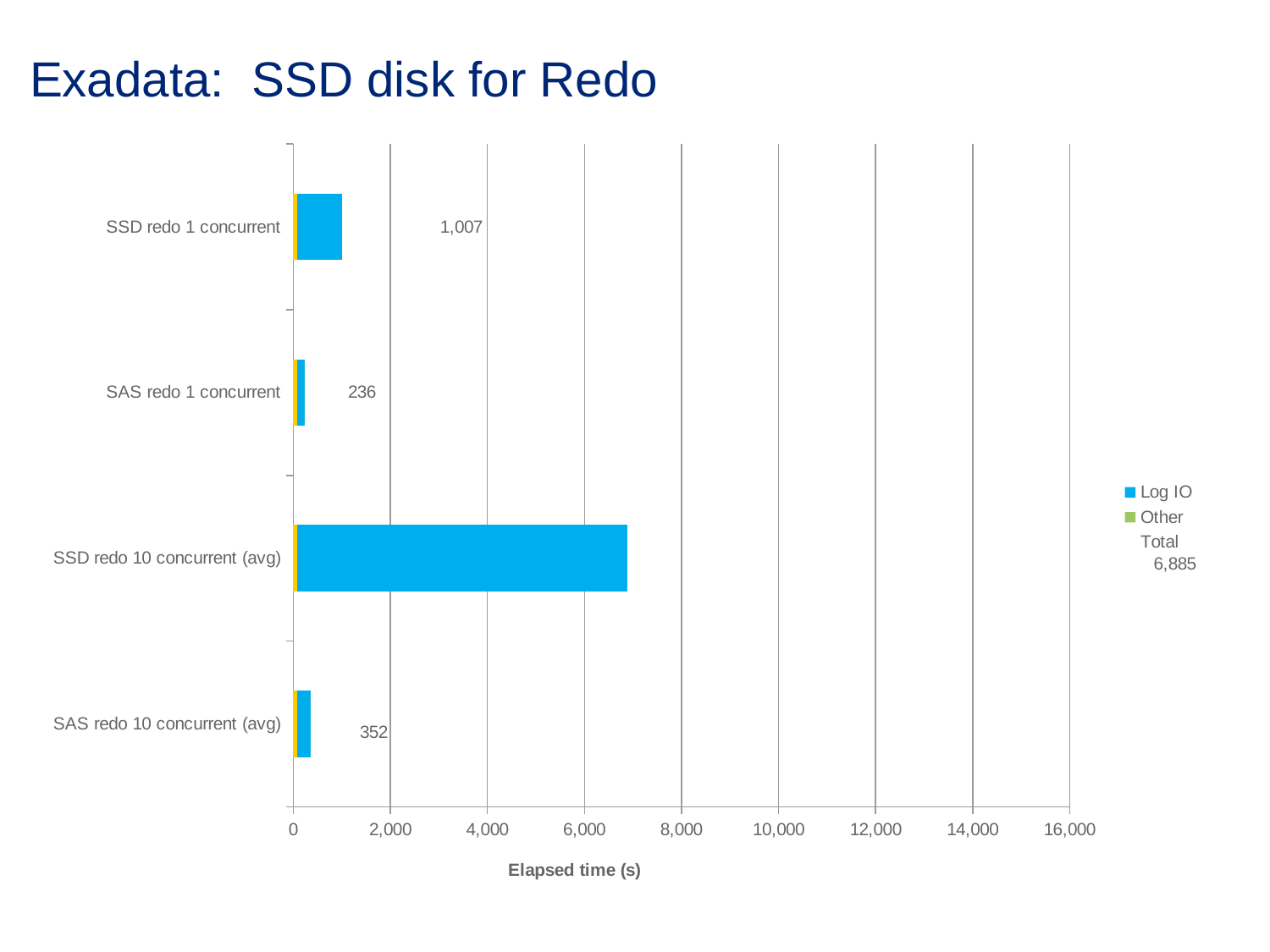
What kind of chart is shown on the slide? bar chart Which category has the longest elapsed time? SSD redo 10 concurrent (avg) Which category has the shortest elapsed time? SAS redo 1 concurrent Is the value for SSD redo 10 concurrent (avg) greater or less than 6,000? greater What is the value shown for SSD redo 1 concurrent? 1,007 What is the value shown for SAS redo 1 concurrent? 236 What is the difference between the values for SSD redo 1 concurrent and SAS redo 1 concurrent? 771 How many categories are shown on the chart? 4 What is the difference between the values for SAS redo 10 concurrent (avg) and SAS redo 1 concurrent? 116 Which is larger: the value for SSD redo 1 concurrent or the value for SAS redo 10 concurrent (avg)? SSD redo 1 concurrent What is the value shown for SAS redo 10 concurrent (avg)? 352 How many series does the legend list? 3